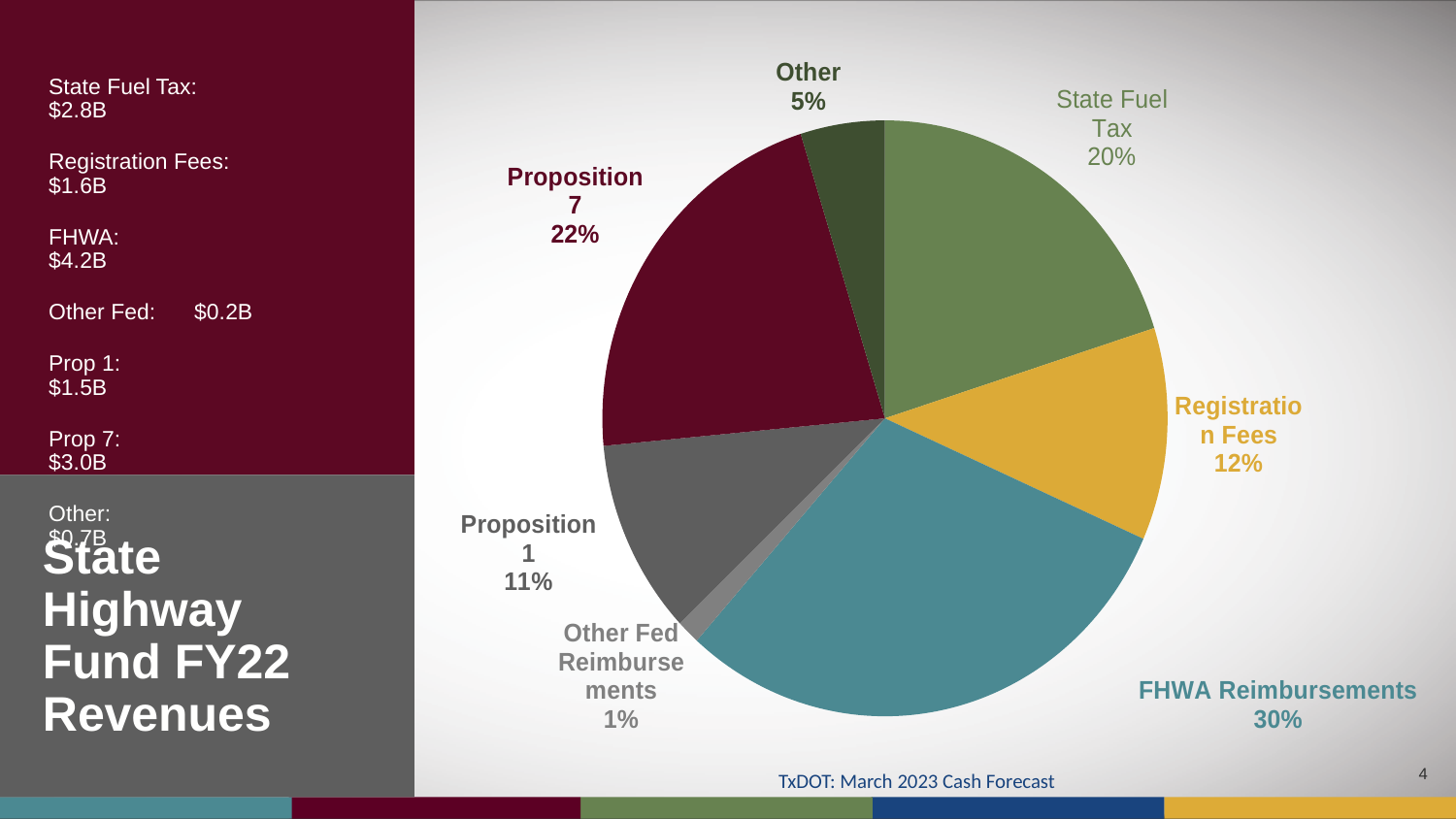
How many slices does the pie chart have? 7 Which is larger, the share for State Fuel Tax or the share for Registration Fees? State Fuel Tax Which slice of the pie is the largest? FHWA Reimbursements What percentage is shown for State Fuel Tax? 20% What share of the pie does FHWA Reimbursements represent? 30% Which slice of the pie is the smallest? Other Fed Reimbursements What is the source cited below the chart? TxDOT: March 2023 Cash Forecast What percentage is shown for Other Fed Reimbursements? 1% What is the difference in percentage points between Proposition 7 and Proposition 1? 11 What kind of chart is shown on the slide? pie chart What percentage is shown for Registration Fees? 12% What percentage is shown for Proposition 7? 22%